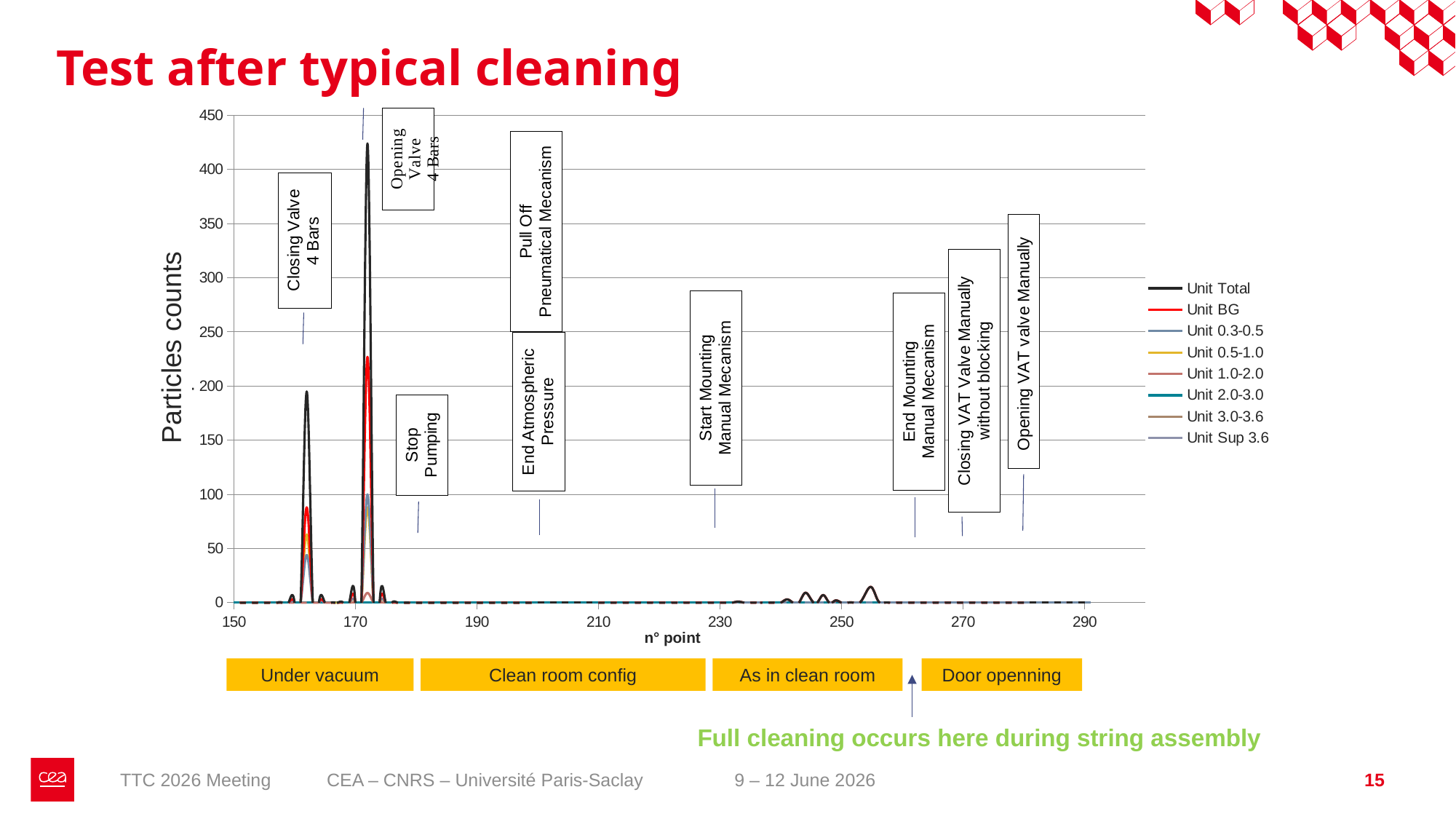
What is the label of the y axis? Particles counts What kind of chart is shown on the slide? line chart Is the peak of the Unit BG series near n° point 172 greater or less than 200? greater Are the Unit Total values after n° point 260 greater or less than 50? less How many series does the legend list? 8 Is the first peak of the Unit Total series (near n° point 162) greater or less than 250? less What is the label of the x axis? n° point What is the highest tick value shown on the y axis? 450 Which series reaches the highest value on the chart? Unit Total Which peak of the Unit Total series is larger: the one near n° point 162 or the one near n° point 172? the one near n° point 172